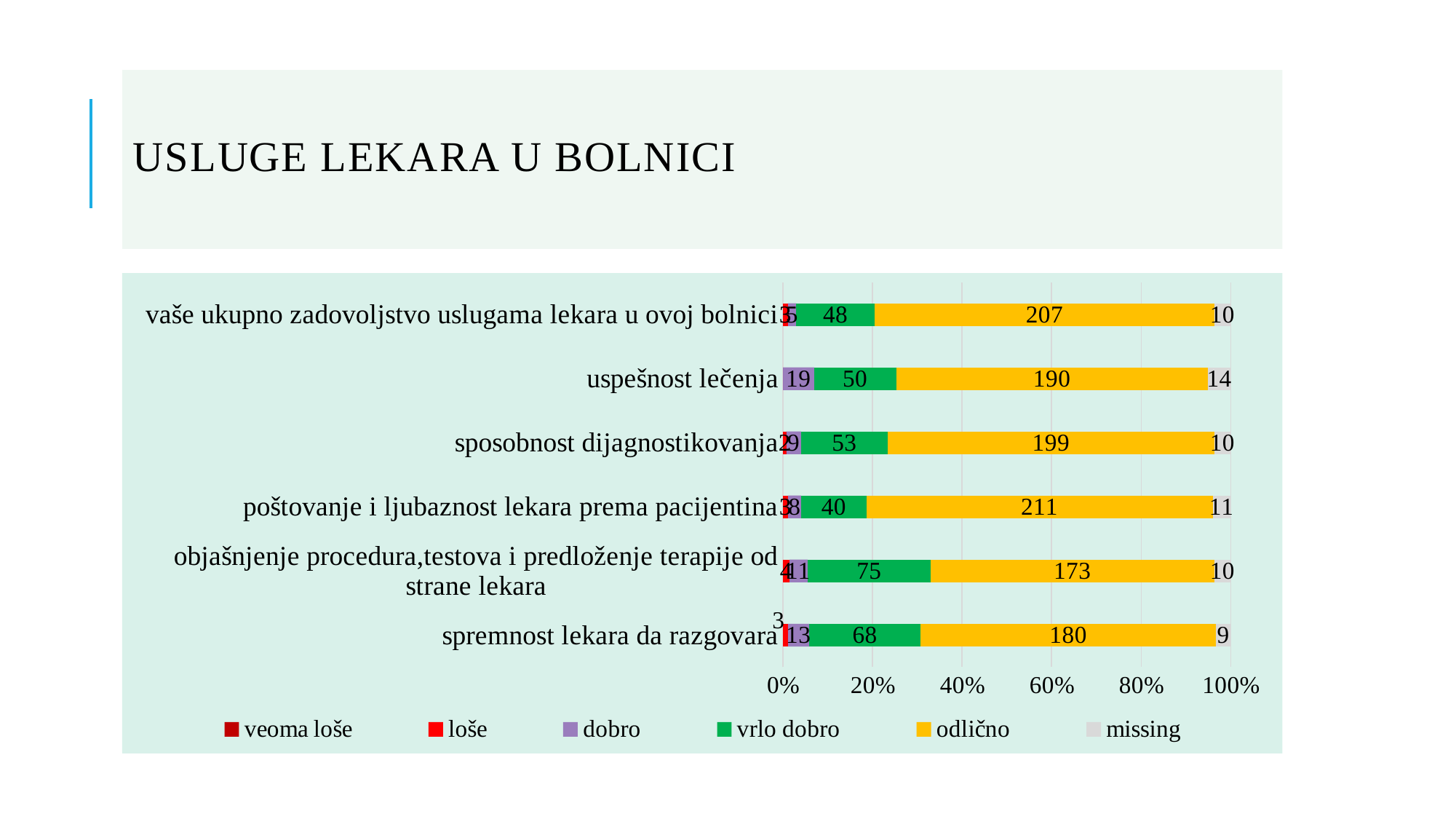
Which category has the lowest 'vrlo dobro' value? poštovanje i ljubaznost lekara prema pacijentina How many categories are shown on the chart? 6 Which legend entry is shown in yellow? odlično What kind of chart is shown on the slide? stacked bar chart How many series does the legend list? 6 What is the 'odlično' value for 'uspešnost lečenja'? 190 What is the 'odlično' value for 'spremnost lekara da razgovara'? 180 Which category has the highest 'odlično' value? poštovanje i ljubaznost lekara prema pacijentina What is the 'missing' value for 'uspešnost lečenja'? 14 What is the 'vrlo dobro' value for 'objašnjenje procedura,testova i predloženje terapije od strane lekara'? 75 Which is larger: the 'vrlo dobro' value for 'spremnost lekara da razgovara' or for 'sposobnost dijagnostikovanja'? spremnost lekara da razgovara What is the difference between the 'odlično' values for 'vaše ukupno zadovoljstvo uslugama lekara u ovoj bolnici' and 'sposobnost dijagnostikovanja'? 8